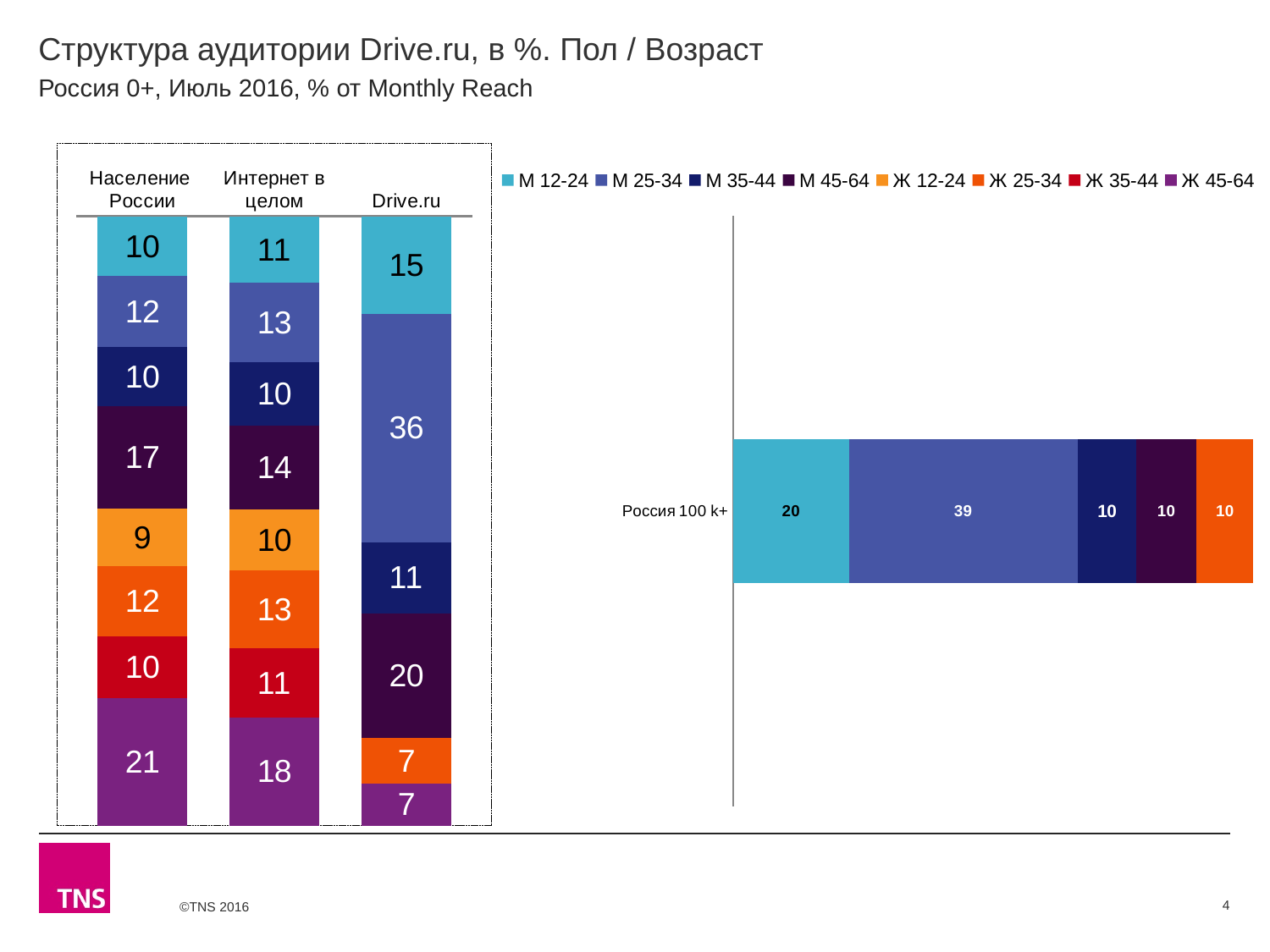
In the left chart, which segment of the Drive.ru bar is the largest? М 25-34 In the left chart, which segment of the Население России bar is the smallest? Ж 12-24 How many bars does the left chart show? 3 In the left chart, what is the value of the М 25-34 segment for Drive.ru? 36 In the right chart, what is the value of the М 25-34 segment for Россия 100 k+? 39 In the right chart, what is the total of the Россия 100 k+ bar? 89 In the left chart, what is the difference between the М 25-34 values for Drive.ru and Население России? 24 In the left chart, which is larger: the М 45-64 value for Drive.ru or for Население России? Drive.ru What kind of chart is the right chart? Stacked bar chart How many series does the legend list? 8 In the left chart, what is the value of the М 45-64 segment for Интернет в целом? 14 In the left chart, what is the value of the Ж 45-64 segment for Население России? 21